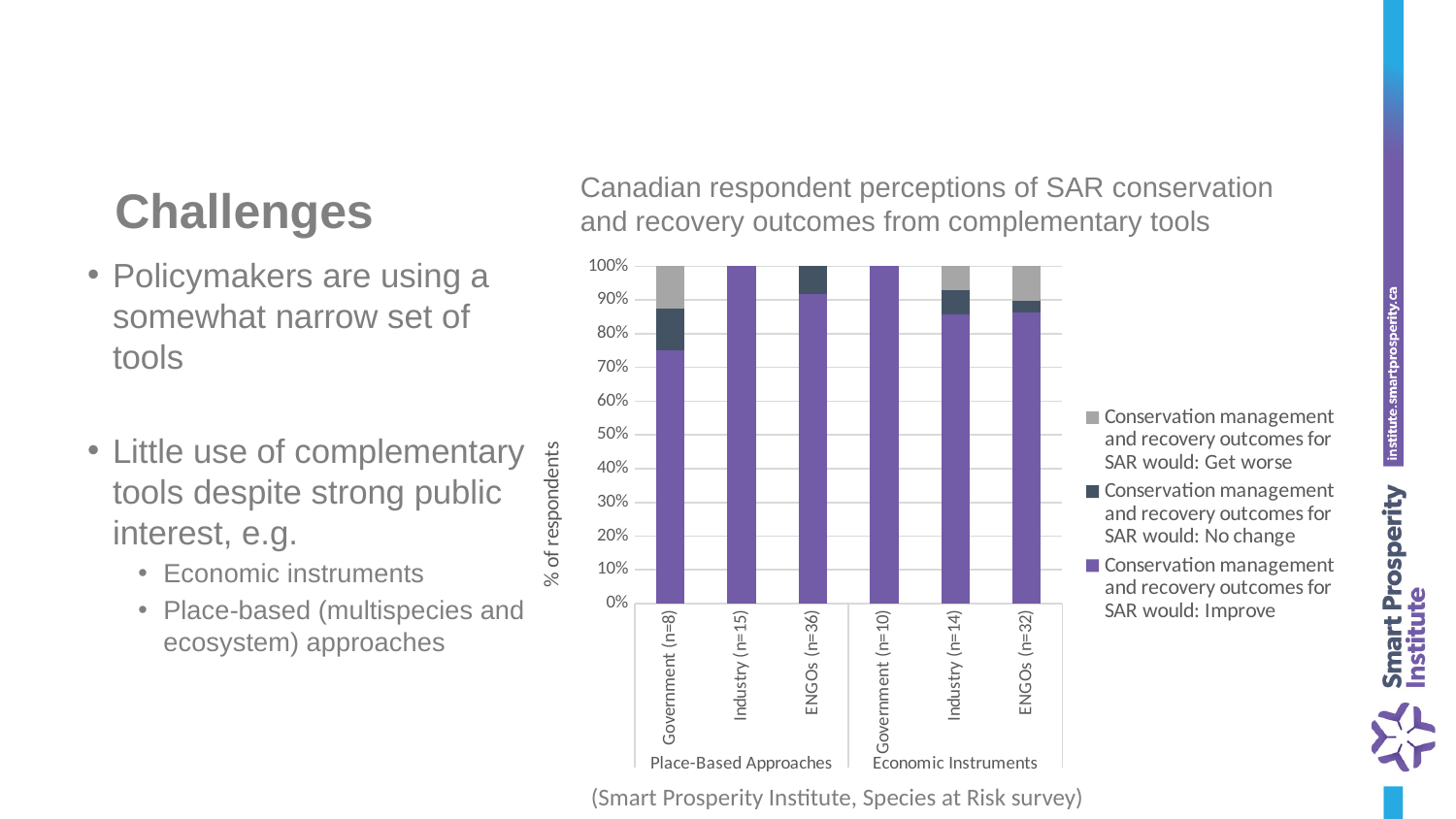
Is the 'Improve' share for Industry (n=14) greater or less than 80%? greater How many series does the legend list? 3 What kind of chart is shown on the slide? Stacked bar chart What is the label on the vertical axis of the chart? % of respondents What is the total of the stacked bar for ENGOs (n=36)? 100% Which has a larger 'Improve' share: Government (n=8) or ENGOs (n=36)? ENGOs (n=36) How many respondent-group bars are plotted in the chart? 6 What are the two groups of complementary tools shown along the x axis? Place-Based Approaches and Economic Instruments What share of Government (n=10) respondents under Economic Instruments said outcomes would improve? 100% Which respondent group has the lowest share saying outcomes would improve? Government (n=8) What share of Industry (n=15) respondents under Place-Based Approaches said outcomes would improve? 100% Is the 'Improve' share for Government (n=8) greater or less than 80%? less